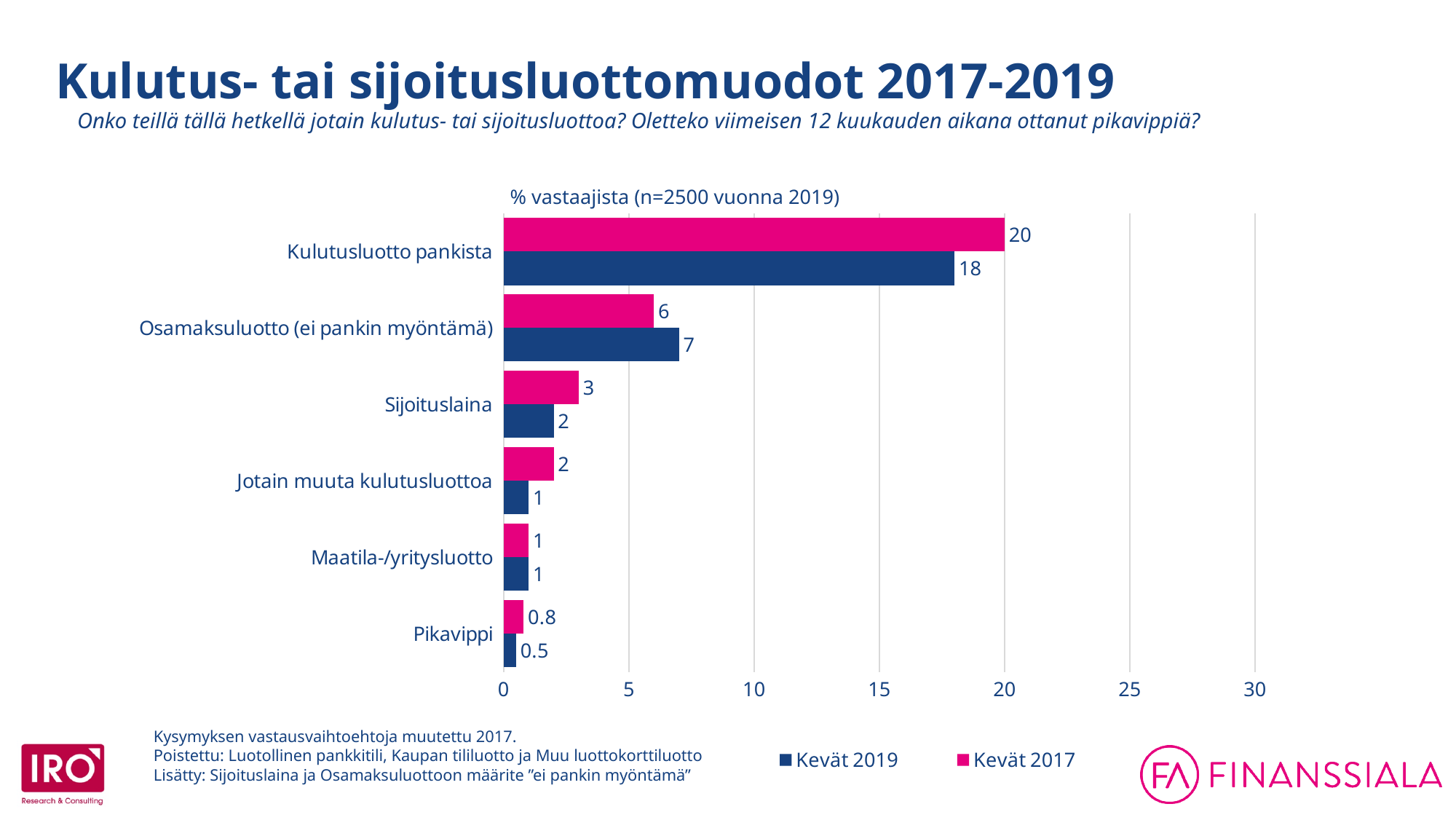
What is the axis title shown above the chart? % vastaajista (n=2500 vuonna 2019) What kind of chart is shown on the slide? Bar chart How many series does the legend list? 2 What is the value for Osamaksuluotto (ei pankin myöntämä) in the Kevät 2017 series? 6 What is the value for Kulutusluotto pankista in the Kevät 2017 series? 20 Which category has the highest value in the Kevät 2019 series? Kulutusluotto pankista For Osamaksuluotto (ei pankin myöntämä), which series has the larger value, Kevät 2019 or Kevät 2017? Kevät 2019 What is the value for Kulutusluotto pankista in the Kevät 2019 series? 18 What is the difference between the Kevät 2017 and Kevät 2019 values for Kulutusluotto pankista? 2 Which category has the lowest value in the Kevät 2017 series? Pikavippi What is the value for Pikavippi in the Kevät 2019 series? 0.5 How many categories are shown on the chart? 6